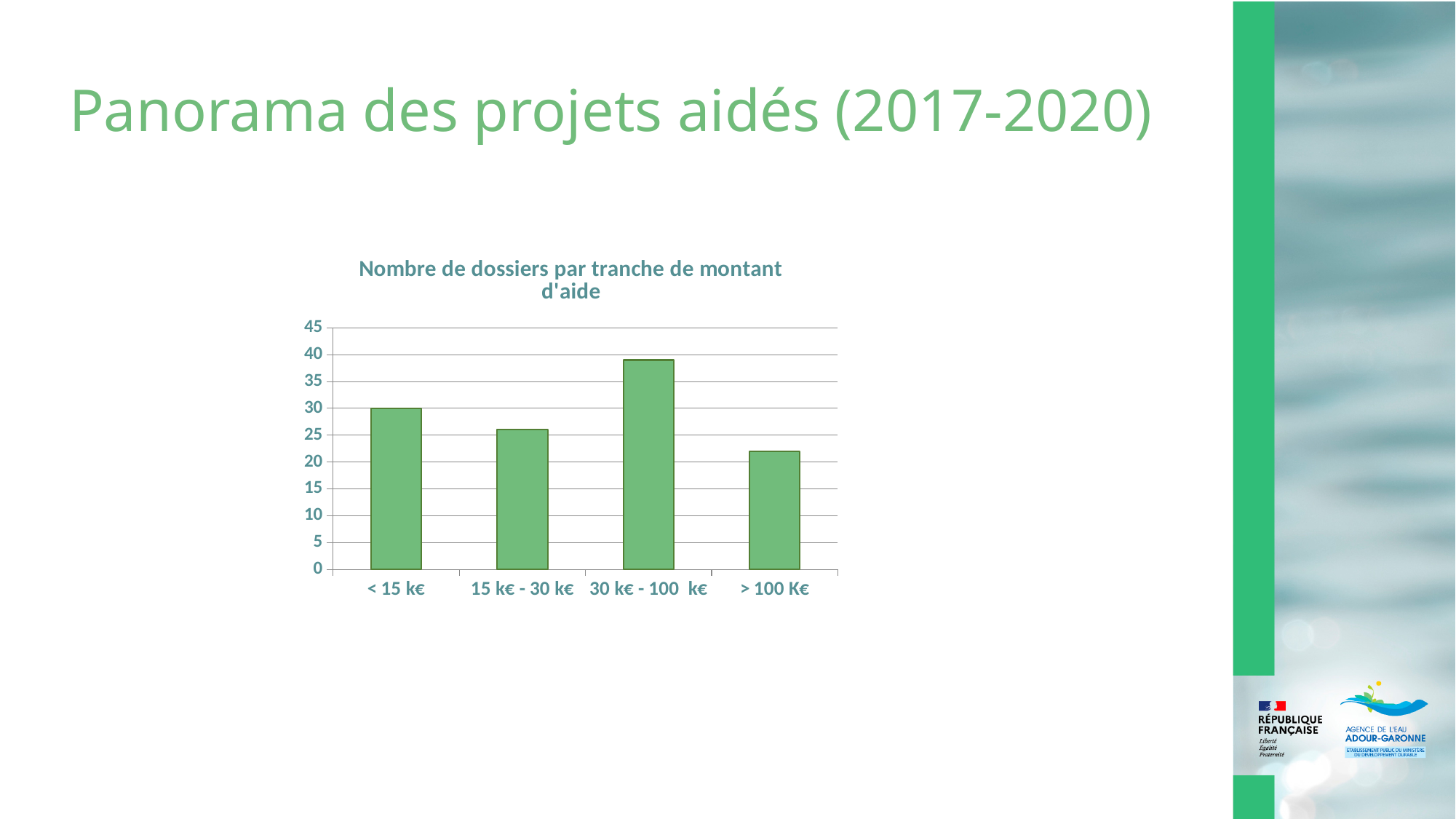
Which tranche has the lowest number of dossiers? > 100 K€ Is the value for 15 k€ - 30 k€ greater or less than 30? less Is the value for 30 k€ - 100 k€ greater or less than 35? greater Is the value for > 100 K€ greater or less than 25? less Which has more dossiers: 30 k€ - 100 k€ or > 100 K€? 30 k€ - 100 k€ What is the title of the chart? Nombre de dossiers par tranche de montant d'aide How many categories (tranches de montant d'aide) are shown on the x axis? 4 What type of chart is shown on the slide? bar chart Which tranche has the highest number of dossiers? 30 k€ - 100 k€ Which has more dossiers: < 15 k€ or 15 k€ - 30 k€? < 15 k€ What is the number of dossiers for the tranche < 15 k€? 30